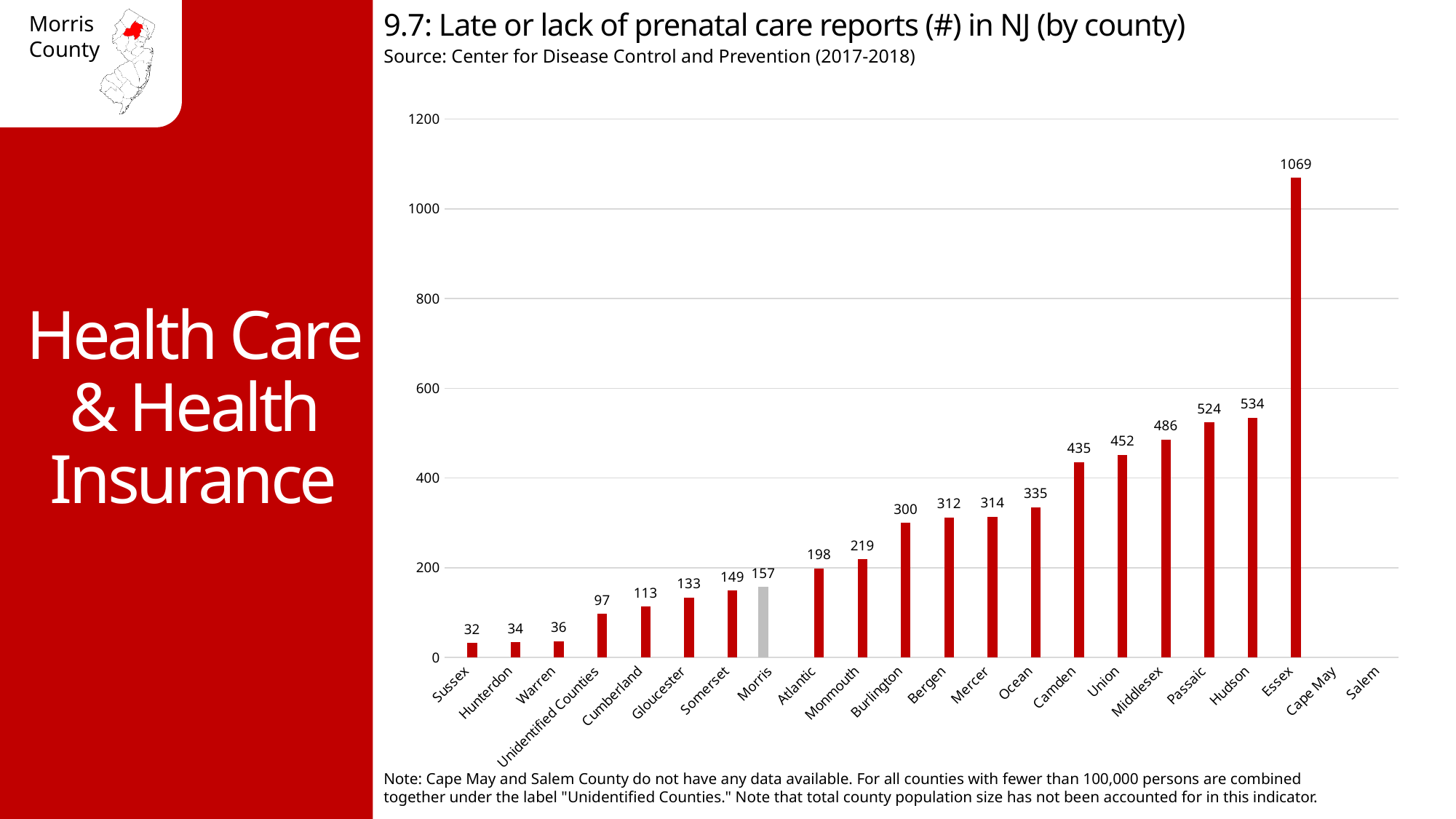
What is the number of late or lack of prenatal care reports for Morris County? 157 What is the difference between the values for Hudson and Passaic? 10 Which bar is colored gray instead of red? Morris Which county has the lowest number of late or lack of prenatal care reports among those with data? Sussex Is the value for Middlesex greater or less than 400? greater What is the value shown for Cumberland County? 113 What is the value shown for Essex County? 1069 What is the difference between the values for Essex and Morris? 912 Which county has the highest number of late or lack of prenatal care reports? Essex Which has a larger value, Camden or Union? Union What kind of chart is shown on the slide? Bar chart How many counties or categories are labeled on the x axis? 22